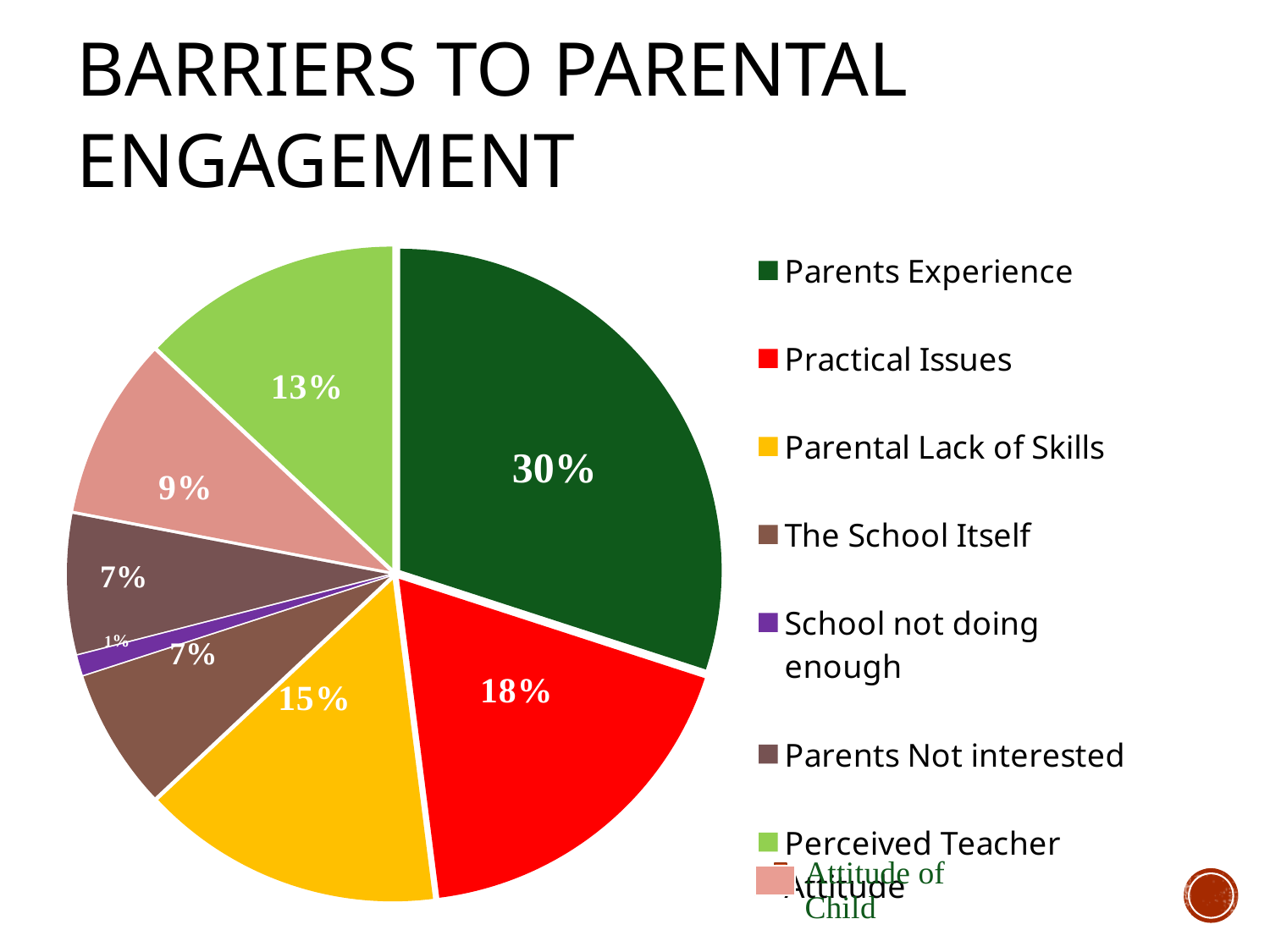
Which is larger, Parental Lack of Skills or Perceived Teacher Attitude? Parental Lack of Skills Which barrier has the smallest share of the pie? School not doing enough What share of the pie is Perceived Teacher Attitude? 13% What percentage is shown for Practical Issues? 18% What percentage is shown for Parental Lack of Skills? 15% How many slices does the pie chart have? 8 What is the difference in percentage points between Parents Experience and Practical Issues? 12 What type of chart is shown on the slide? Pie chart Which barrier has the largest share of the pie? Parents Experience What percentage is shown for Attitude of Child? 9% What colour is the slice for Practical Issues? Red What share of the pie does Parents Experience represent? 30%